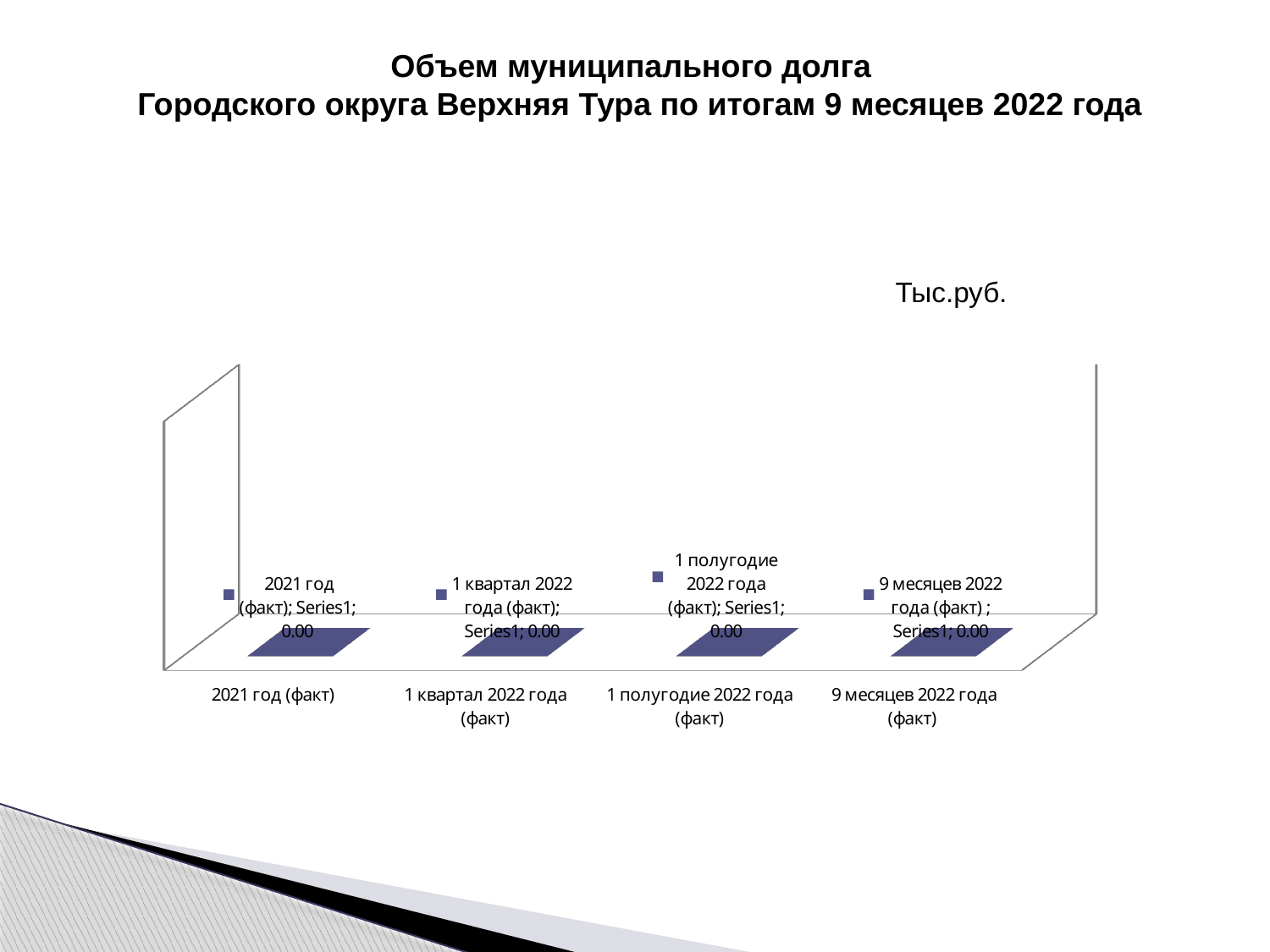
What is the value for 2021 год (факт)? 0.00 What kind of chart is shown on the slide? bar chart How many categories are shown on the x axis of the chart? 4 What unit of measurement is indicated above the chart? Тыс.руб. Do the values rise, fall, or stay the same from 2021 год (факт) to 9 месяцев 2022 года (факт)? stay the same Is the value for 1 квартал 2022 года (факт) larger than, smaller than, or equal to the value for 1 полугодие 2022 года (факт)? equal What is the value for 1 квартал 2022 года (факт)? 0.00 What is the value for 9 месяцев 2022 года (факт)? 0.00 What is the difference between the value for 9 месяцев 2022 года (факт) and the value for 2021 год (факт)? 0.00 What is the title of the chart on the slide? Объем муниципального долга Городского округа Верхняя Тура по итогам 9 месяцев 2022 года What is the value for 1 полугодие 2022 года (факт)? 0.00